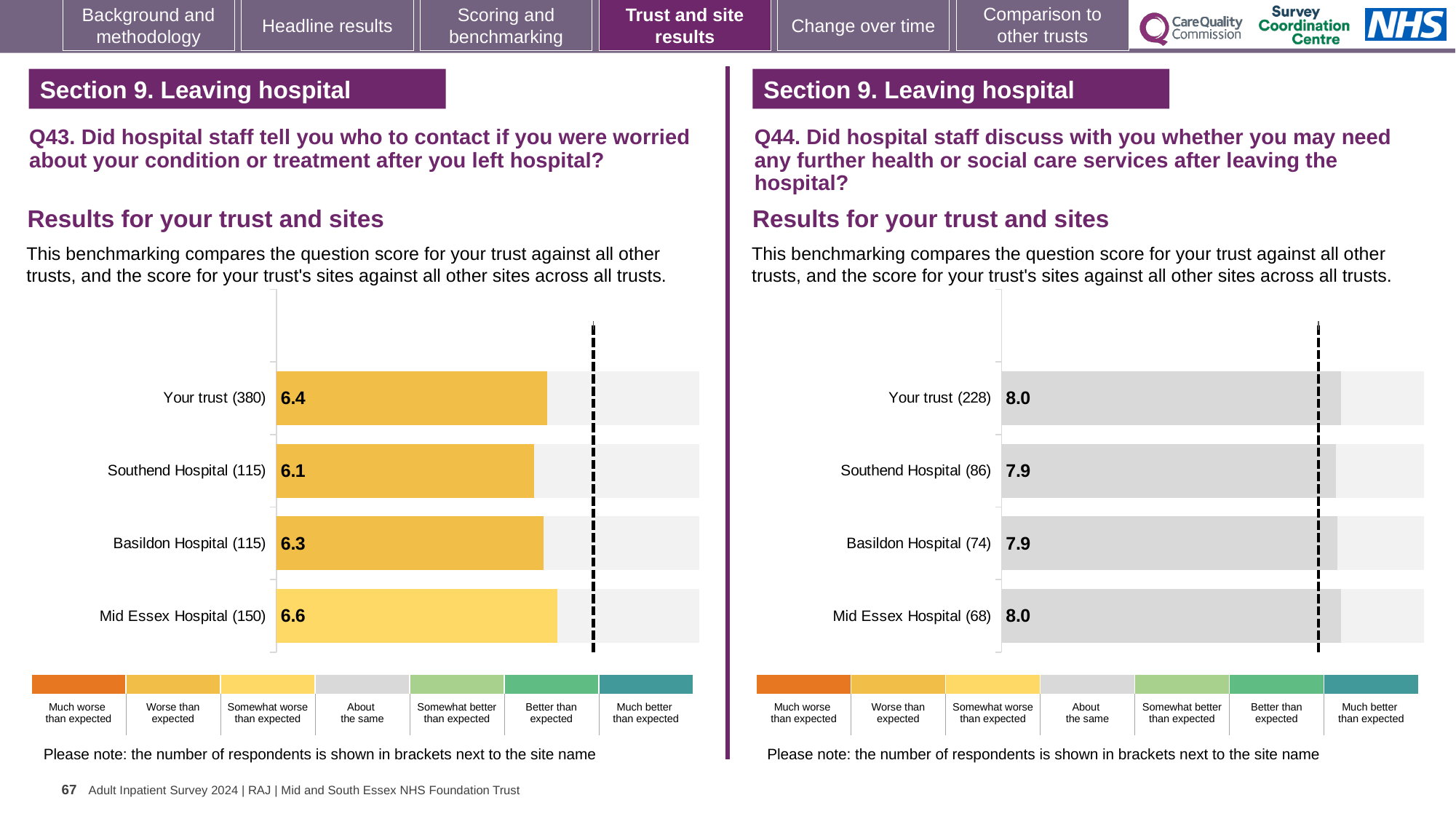
In the Q44 chart on the right, what is the score for Mid Essex Hospital (68)? 8.0 What type of chart is used in the Q44 chart on the right? Bar chart In the Q43 chart on the left, what is the difference between the scores for Mid Essex Hospital (150) and Southend Hospital (115)? 0.5 In the Q43 chart on the left, how many bars are plotted? 4 In the Q43 chart on the left, which site or trust has the highest score? Mid Essex Hospital (150) In the Q43 chart on the left, what is the score for Your trust (380)? 6.4 In the Q43 chart on the left, what is the score for Southend Hospital (115)? 6.1 In the Q44 chart on the right, what is the score for Basildon Hospital (74)? 7.9 In the Q43 chart on the left, which site or trust has the lowest score? Southend Hospital (115) In the Q43 chart on the left, which has the larger score, Basildon Hospital (115) or Southend Hospital (115)? Basildon Hospital (115) In the Q44 chart on the right, what is the difference between the scores for Your trust (228) and Southend Hospital (86)? 0.1 In the Q44 chart on the right, which benchmark category does the colour of the bars correspond to according to the legend? About the same